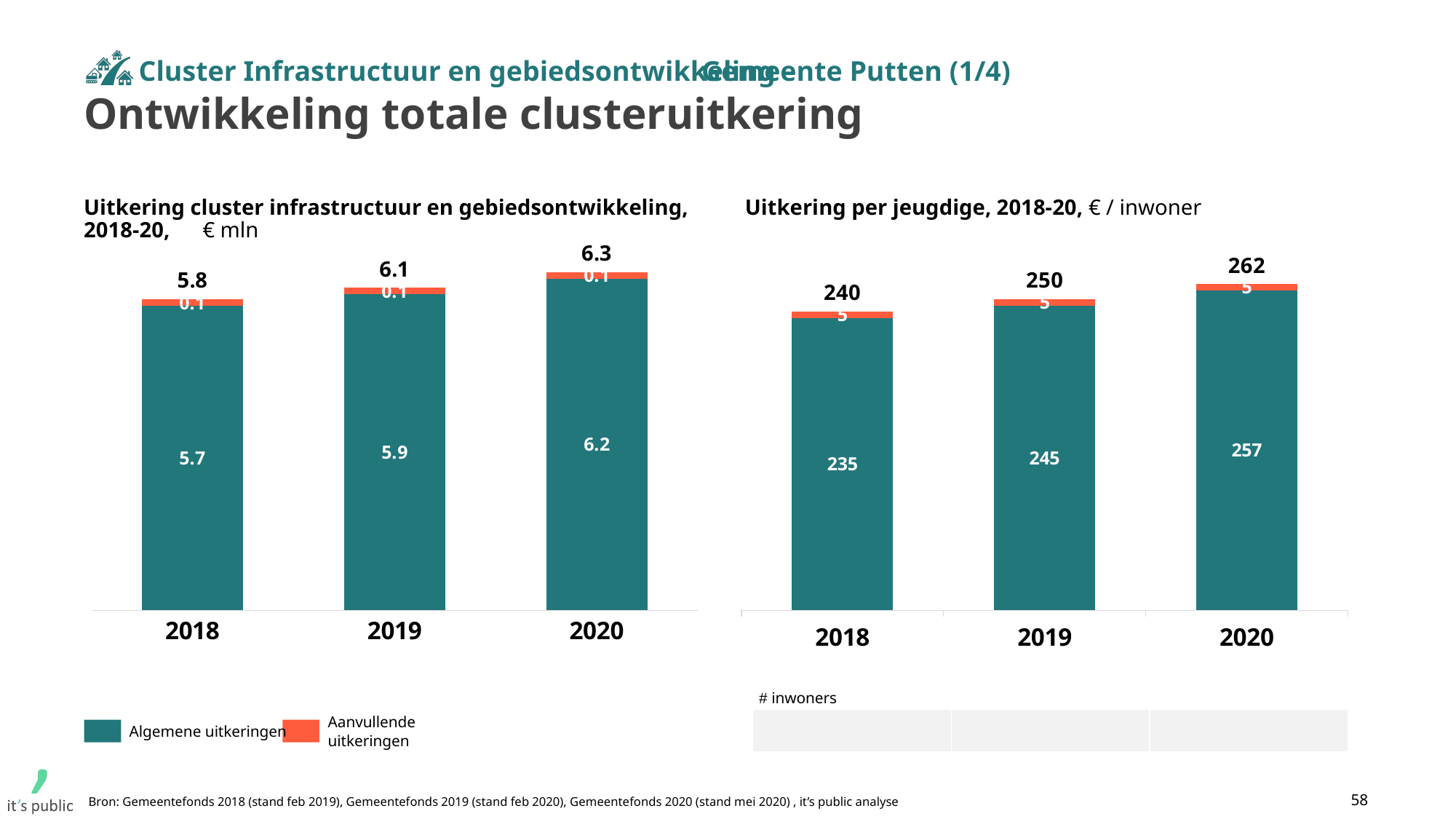
In the left chart (Uitkering cluster infrastructuur en gebiedsontwikkeling), what is the value of Aanvullende uitkeringen for 2019? 0.1 In the right chart (Uitkering per jeugdige), do the totals rise or fall from 2018 to 2020? rise In the right chart (Uitkering per jeugdige), what is the difference between the Algemene uitkeringen values for 2020 and 2018? 22 In the left chart (Uitkering cluster infrastructuur en gebiedsontwikkeling), what is the total labelled above the 2020 bar? 6.3 In the left chart (Uitkering cluster infrastructuur en gebiedsontwikkeling), which year has the lowest total? 2018 How many series does the legend list for the left chart? 2 In the right chart (Uitkering per jeugdige), what is the total labelled above the 2018 bar? 240 In the right chart (Uitkering per jeugdige), what is the value of Algemene uitkeringen for 2019? 245 How many years are shown on the x axis of the left chart (Uitkering cluster infrastructuur en gebiedsontwikkeling)? 3 In the right chart (Uitkering per jeugdige), which year has the highest total? 2020 In the left chart (Uitkering cluster infrastructuur en gebiedsontwikkeling), what is the difference between the Algemene uitkeringen values for 2020 and 2018? 0.5 In the left chart (Uitkering cluster infrastructuur en gebiedsontwikkeling), what is the value of Algemene uitkeringen for 2018? 5.7